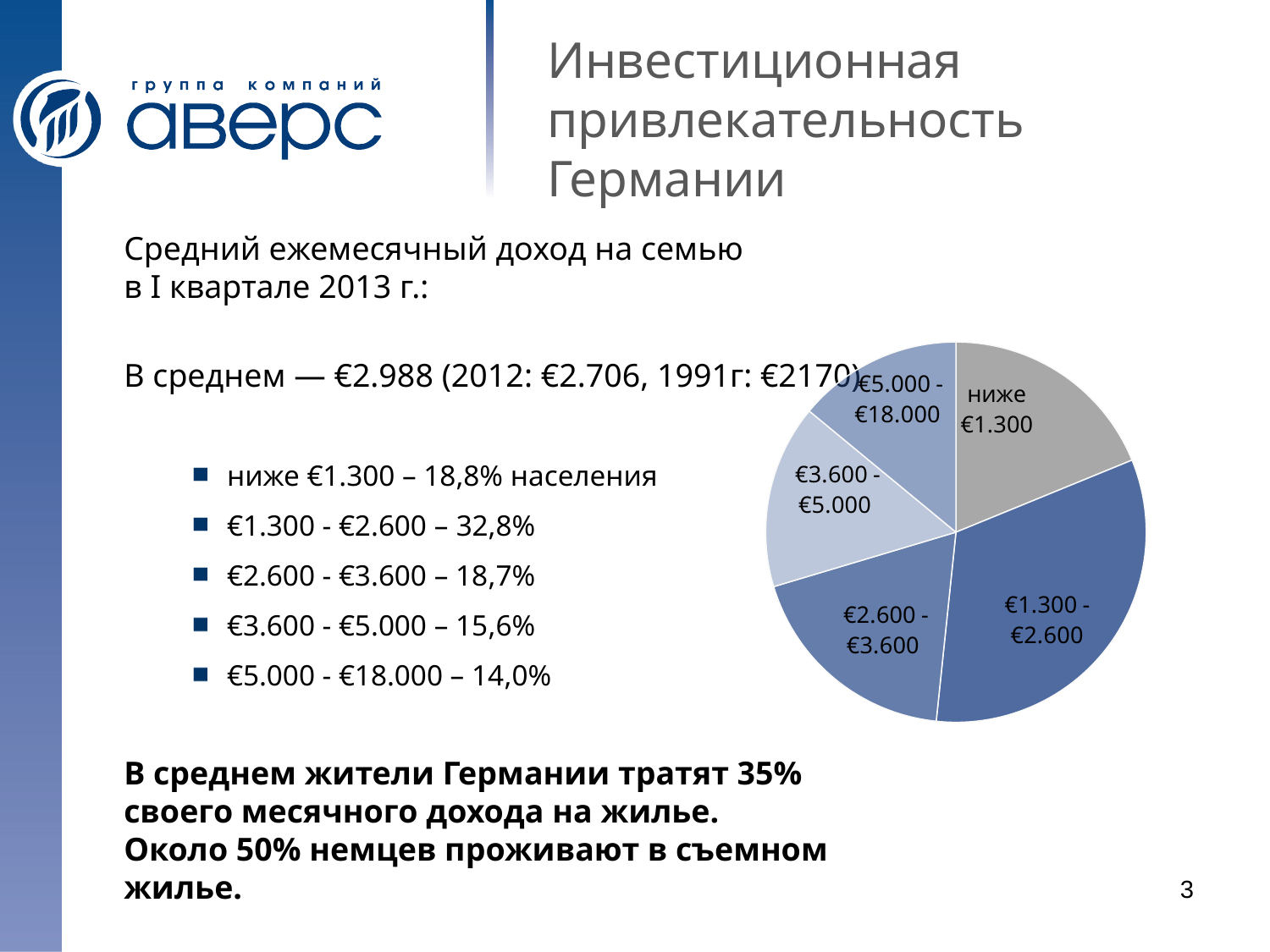
Is the share for the €1.300 - €2.600 category greater or less than 30%? greater Which slice is larger: €2.600 - €3.600 or €3.600 - €5.000? €2.600 - €3.600 Which income category has the largest slice of the pie chart? €1.300 - €2.600 What share of the population has income below €1.300 (ниже €1.300)? 18,8% What share of the population falls in the €3.600 - €5.000 category? 15,6% What share of the population falls in the €1.300 - €2.600 category? 32,8% What is the difference in percentage points between the €1.300 - €2.600 share and the €2.600 - €3.600 share? 14,1 What kind of chart is shown on the slide? pie chart Which income category has the smallest slice of the pie chart? €5.000 - €18.000 Which slice of the pie chart is coloured grey? ниже €1.300 How many slices does the pie chart have? 5